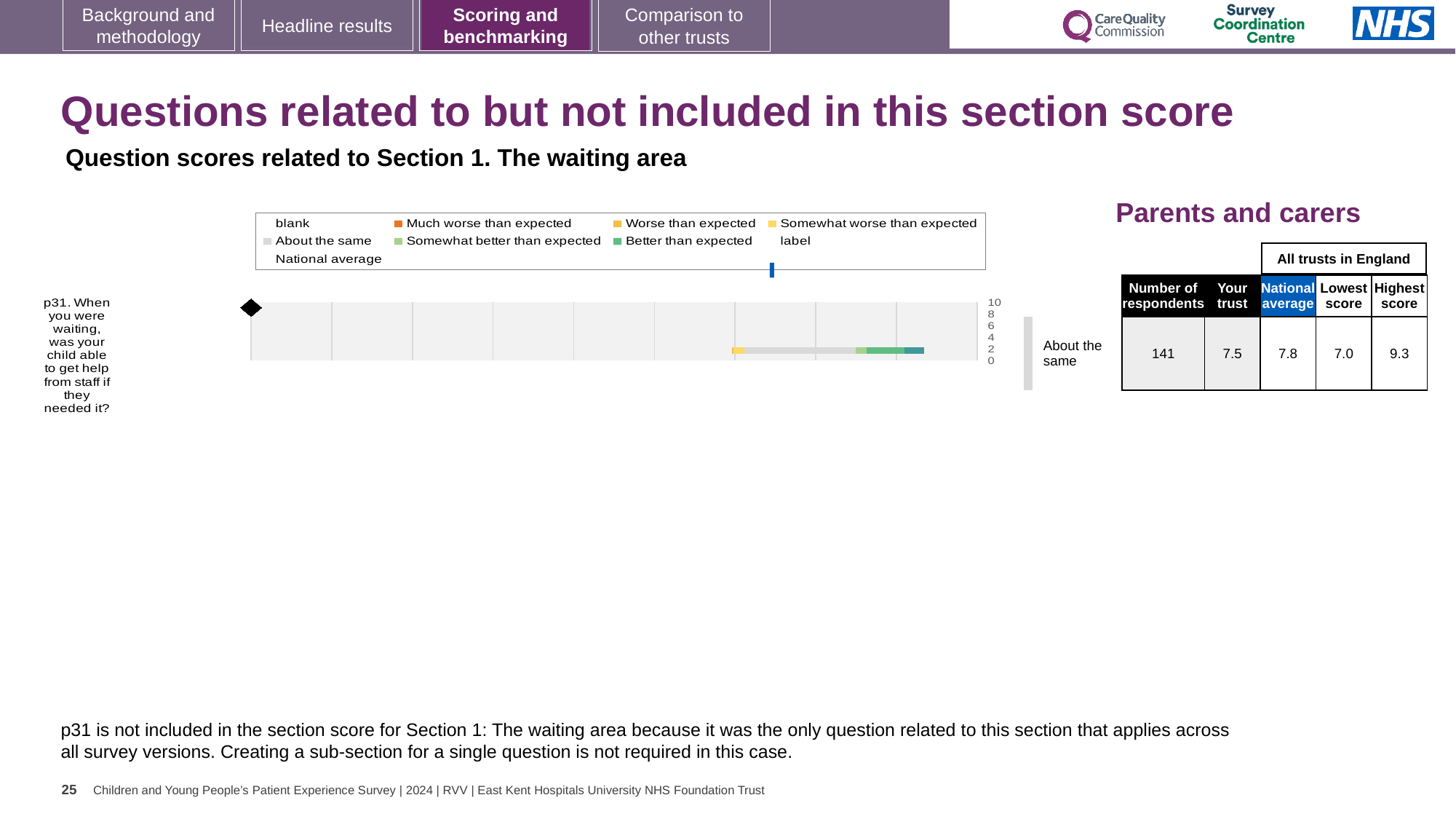
Is the 'Your trust' score for p31 higher or lower than the national average? lower What is the maximum value shown on the chart's axis? 10 How many respondents answered p31? 141 What is the highest score among all trusts in England for p31? 9.3 How many questions are plotted in the chart? 1 What is the 'Your trust' score for p31 in the table? 7.5 What is the difference between the highest score and the lowest score for p31? 2.3 What rating label is shown next to the bar for p31? About the same Which question is plotted in the chart? p31. When you were waiting, was your child able to get help from staff if they needed it? What kind of chart is used to show the p31 question score? bar chart What is the national average score for p31? 7.8 What is the lowest score among all trusts in England for p31? 7.0